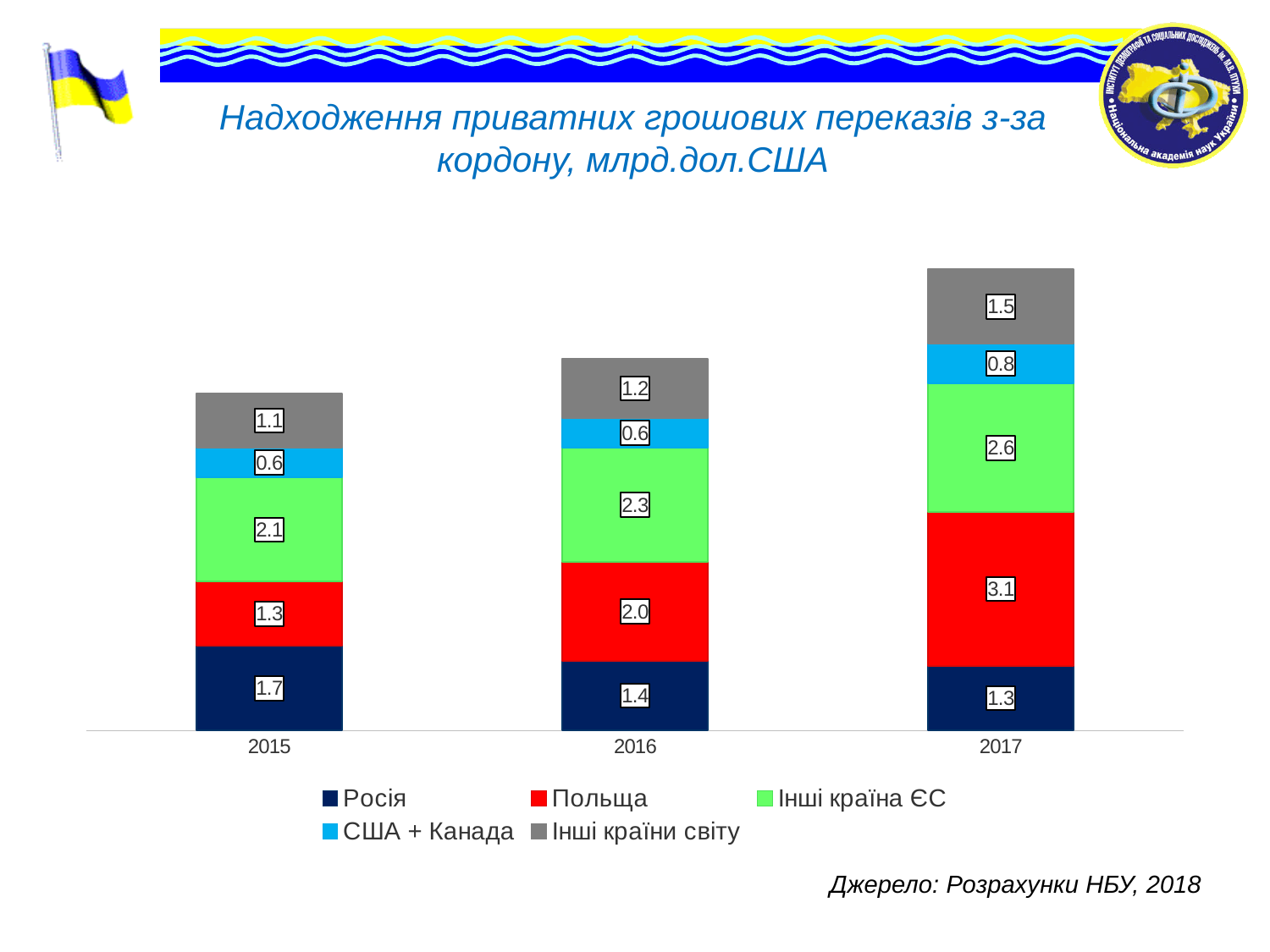
What is the total of the stacked bar for 2015? 6.8 Which is larger: the value for Росія in 2016 or the value for Польща in 2016? Польща in 2016 How many series does the legend list? 5 What is the difference between the value for Інші країна ЄС in 2017 and in 2015? 0.5 In which year is the value for Росія the lowest? 2017 What is the value for Інші країни світу in 2016? 1.2 What is the total of the stacked bar for 2017? 9.3 What kind of chart is shown on the slide? Stacked bar chart What is the value for США + Канада in 2017? 0.8 In which year is the value for Польща the highest? 2017 What is the value for Росія in 2015? 1.7 What is the value for Польща in 2017? 3.1